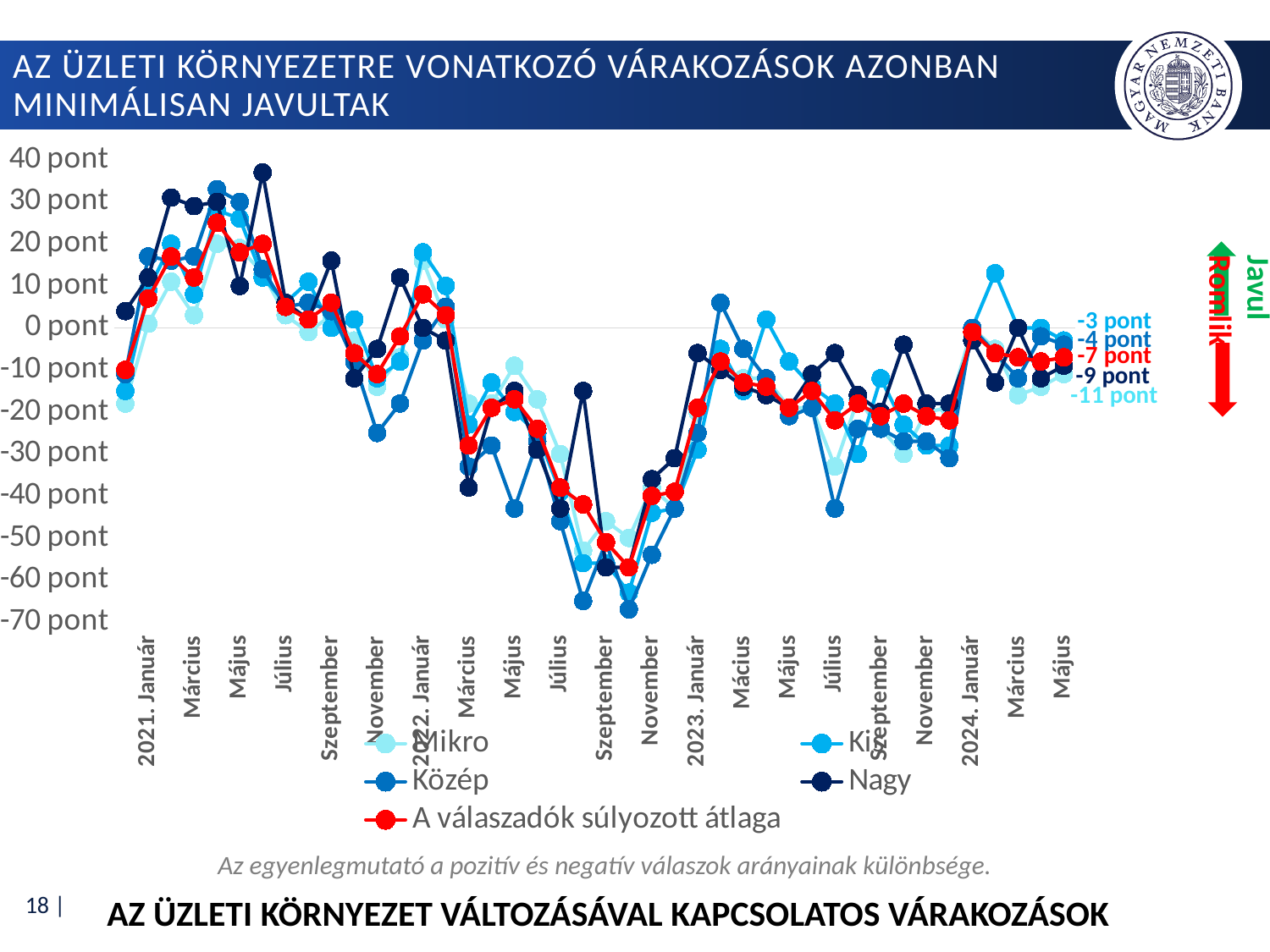
Is the value for 'A válaszadók súlyozott átlaga' in November 2022 greater or less than -50 pont? greater What is the latest value shown for the Nagy series at the right end of the chart? -9 pont How many series does the legend list? 5 What is the latest value shown for the Kis series at the right end of the chart? -3 pont What is the latest value shown for the Mikro series at the right end of the chart? -11 pont What is the latest value shown for 'A válaszadók súlyozott átlaga' at the right end of the chart? -7 pont What kind of chart is shown on the slide? line chart Which series has the highest value at the right end of the chart? Kis At the right end of the chart, which is larger: the Közép value or the Nagy value? Közép Which series has the lowest value at the right end of the chart? Mikro What is the difference between the end values of the Kis series (-3 pont) and the Mikro series (-11 pont)? 8 pont Is the value for the Nagy series in July 2021 greater or less than 30 pont? less